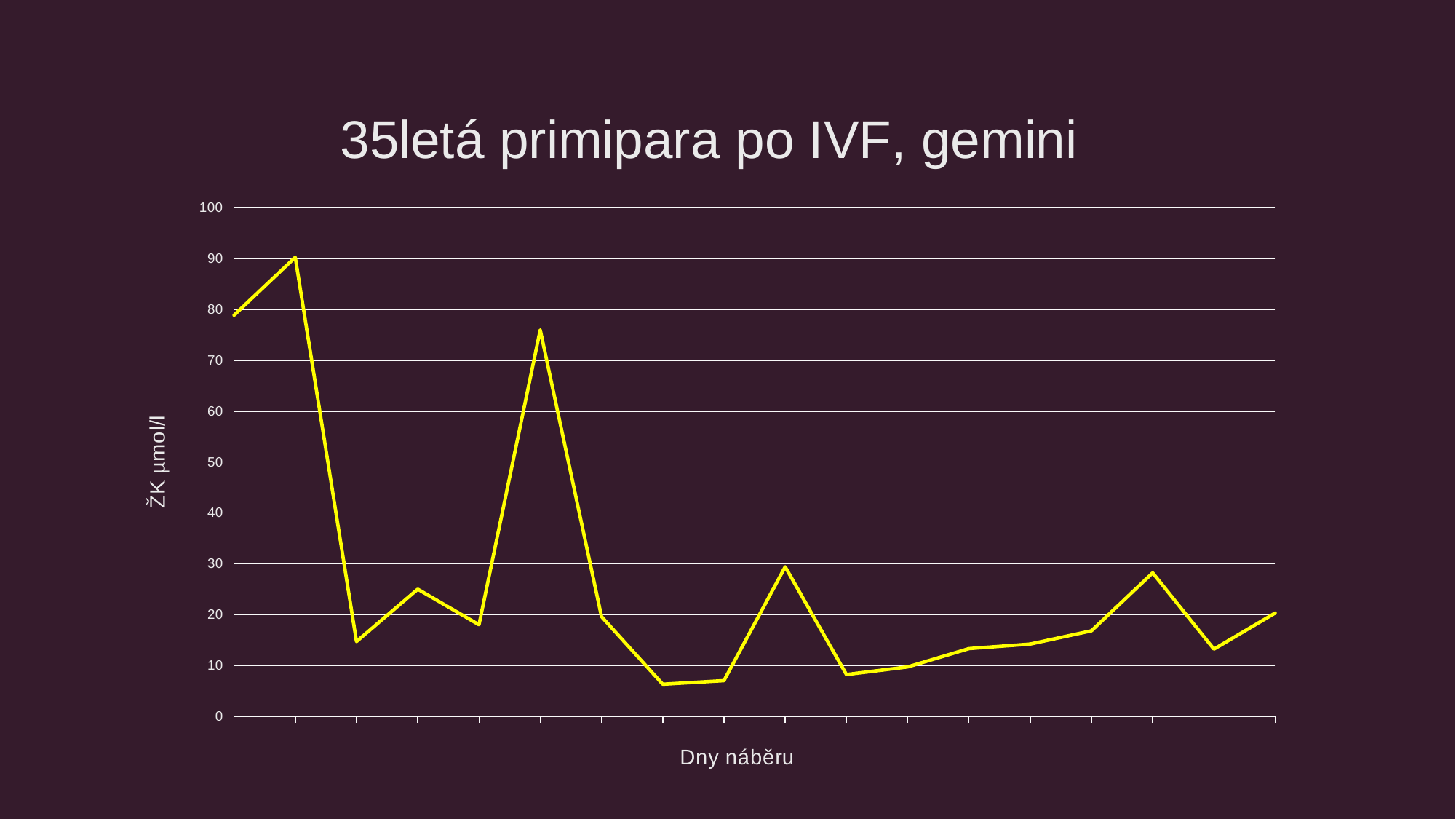
What kind of chart is shown on the slide? line chart How many data points are plotted on the line? 18 Does the line generally rise or fall from the first data point to the last? fall Which is larger, the value of the second data point or the value of the sixth data point? the second data point Is the value of the third data point greater or less than 20? less Which data point has the highest value on the line? the second data point Is the value of the second data point greater or less than 80? greater Is the value of the first data point greater or less than 70? greater What is the label of the vertical axis? ŽK µmol/l What is the title of the chart? 35letá primipara po IVF, gemini